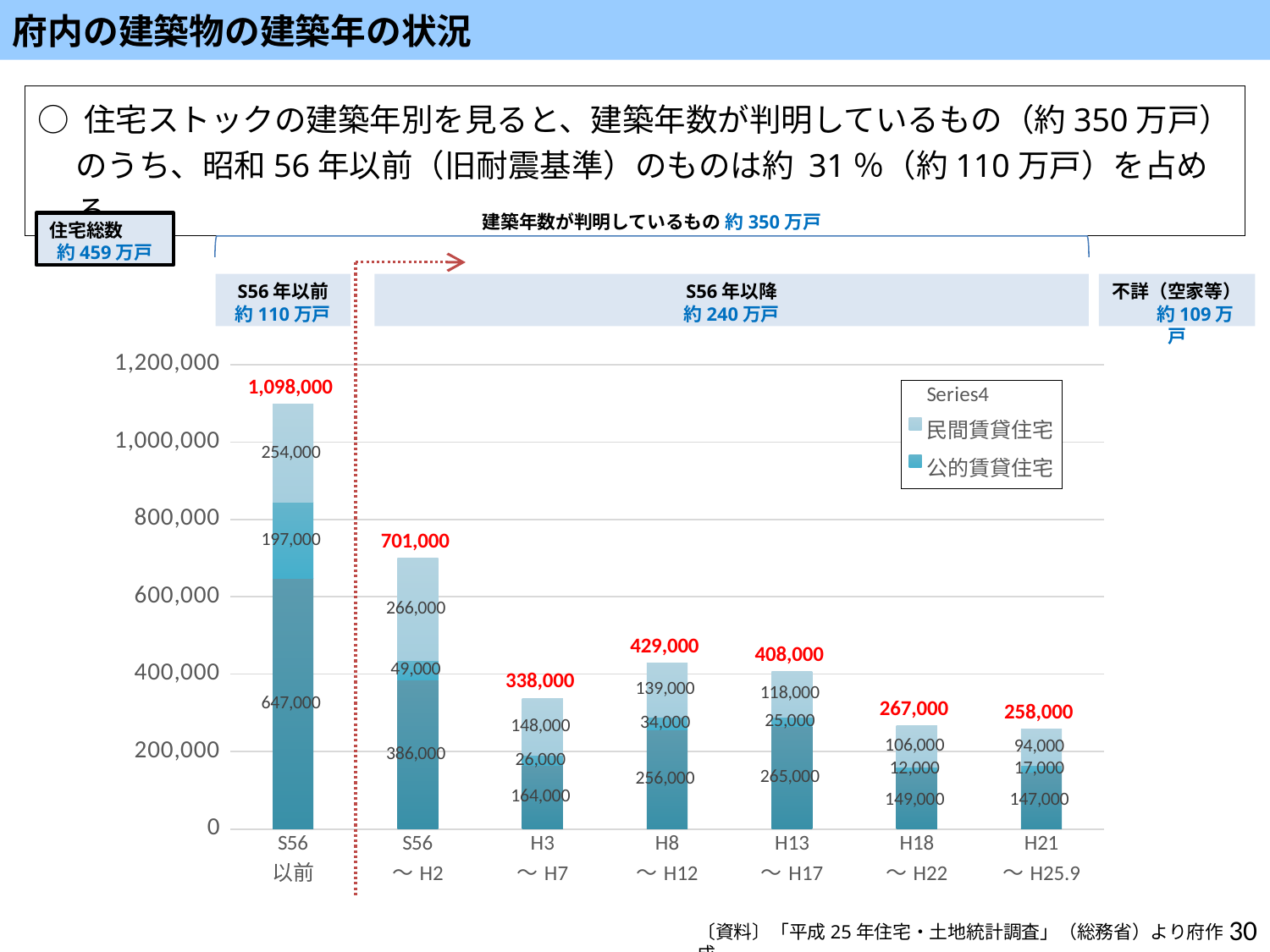
What kind of chart is shown on the slide? Stacked bar chart Which category has the highest total? S56以前 What is the value of the 公的賃貸住宅 segment in the H13〜H17 bar? 25,000 Which category has the lowest total? H21〜H25.9 Which has a larger total, H8〜H12 or H13〜H17? H8〜H12 How many entries does the legend list? 3 What is the value of the bottom segment in the H3〜H7 bar? 164,000 What is the total value printed above the H8〜H12 bar? 429,000 What is the difference between the totals of the S56以前 bar and the S56〜H2 bar? 397,000 How many categories are shown on the x axis? 7 What is the value of the 民間賃貸住宅 segment in the S56〜H2 bar? 266,000 What is the total value printed above the S56以前 bar? 1,098,000